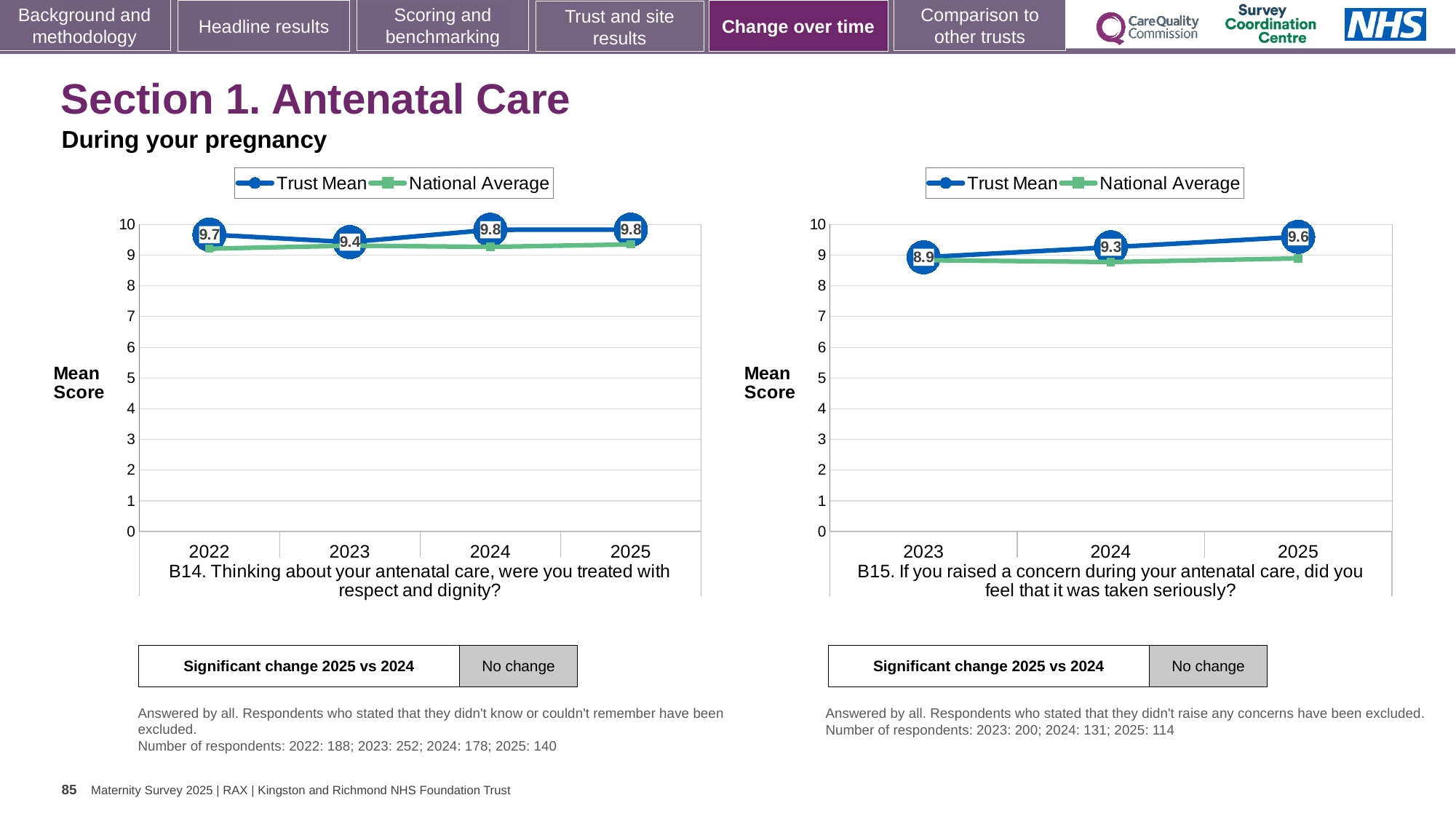
What kind of chart is the B14 chart (left)? line chart How many years are plotted on the x axis of the B14 chart (left)? 4 In the B14 chart (left), what is the Trust Mean for 2022? 9.7 In the B14 chart (left), what is the difference between the Trust Mean in 2024 and in 2023? 0.4 In the B15 chart (right), which year has the lowest Trust Mean? 2023 In the B15 chart (right), which year has the highest Trust Mean? 2025 In the B15 chart (right), what is the Trust Mean for 2025? 9.6 In the B15 chart (right), what is the difference between the Trust Mean in 2025 and in 2023? 0.7 How many series does the legend of the B15 chart (right) list? 2 In the B14 chart (left), what is the Trust Mean for 2023? 9.4 In the B15 chart (right), does the Trust Mean rise or fall from 2023 to 2025? rise In the B14 chart (left), which year has the lowest Trust Mean? 2023